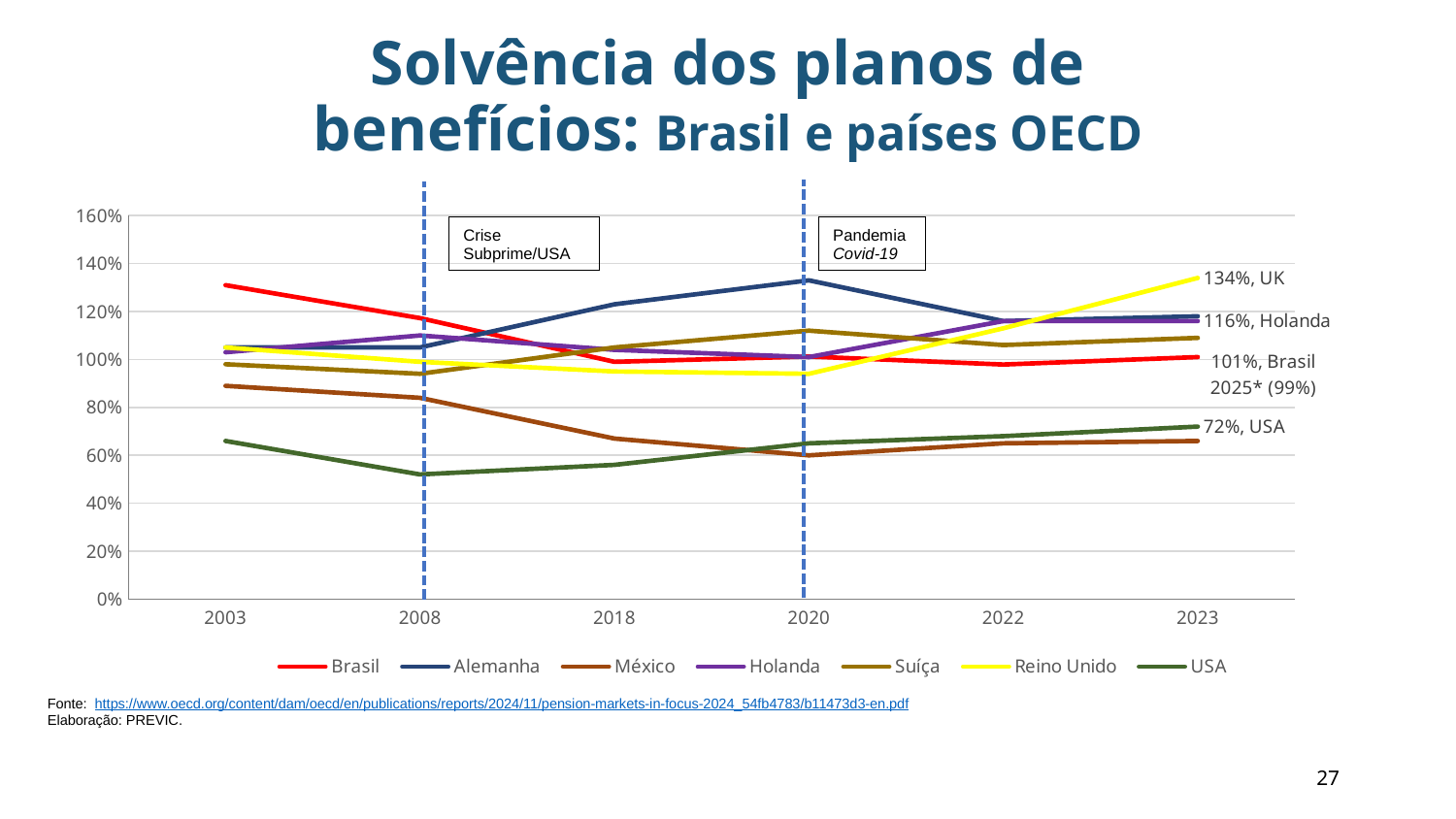
Is the value for Brasil in 2003 greater or less than 120%? greater Does the USA line rise or fall from 2008 to 2023? rise What is the difference between the UK value and the USA value in 2023? 62 percentage points What kind of chart is shown on the slide? line chart What is the value for Holanda in 2023? 116% What is the value for USA in 2023? 72% Which series has the highest value in 2023? Reino Unido (UK) How many years are shown on the x axis? 6 What is the value for Brasil in 2023? 101% What is the value for UK (Reino Unido) in 2023? 134% How many series does the legend list? 7 Which event is marked by the dashed line at 2008? Crise Subprime/USA